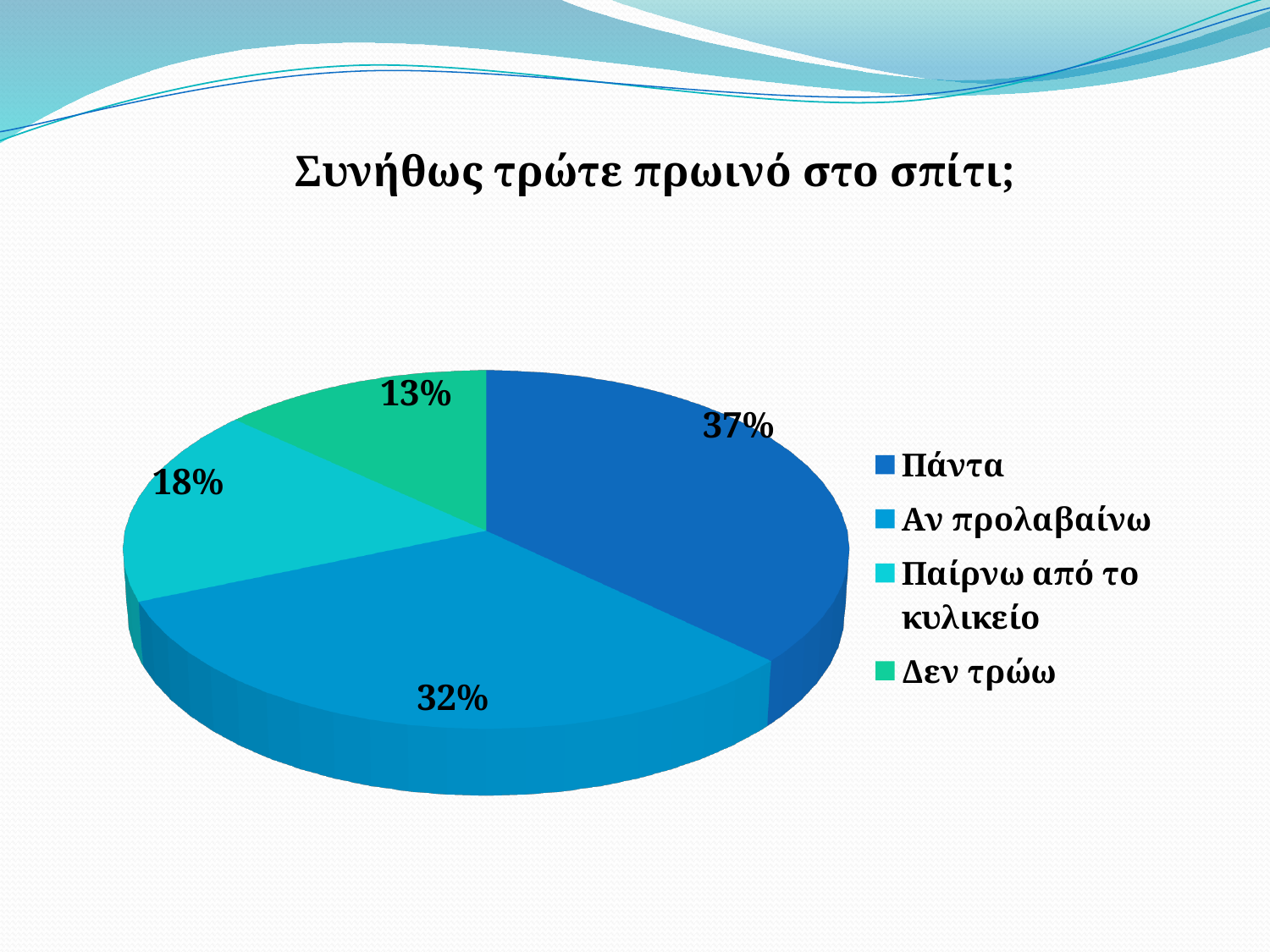
What percentage of the pie is labelled 'Παίρνω από το κυλικείο'? 18% Which is larger, the share for 'Παίρνω από το κυλικείο' or the share for 'Δεν τρώω'? Παίρνω από το κυλικείο What percentage of the pie is labelled 'Δεν τρώω'? 13% Which category has the smallest share of the pie? Δεν τρώω What is the title of the chart? Συνήθως τρώτε πρωινό στο σπίτι; What is the combined share of 'Παίρνω από το κυλικείο' and 'Δεν τρώω'? 31% What percentage of the pie is labelled 'Αν προλαβαίνω'? 32% Which category has the largest share of the pie? Πάντα How many categories does the legend list? 4 What is the difference in percentage points between 'Πάντα' and 'Αν προλαβαίνω'? 5% What type of chart is shown on the slide? pie chart What percentage of the pie is labelled 'Πάντα'? 37%